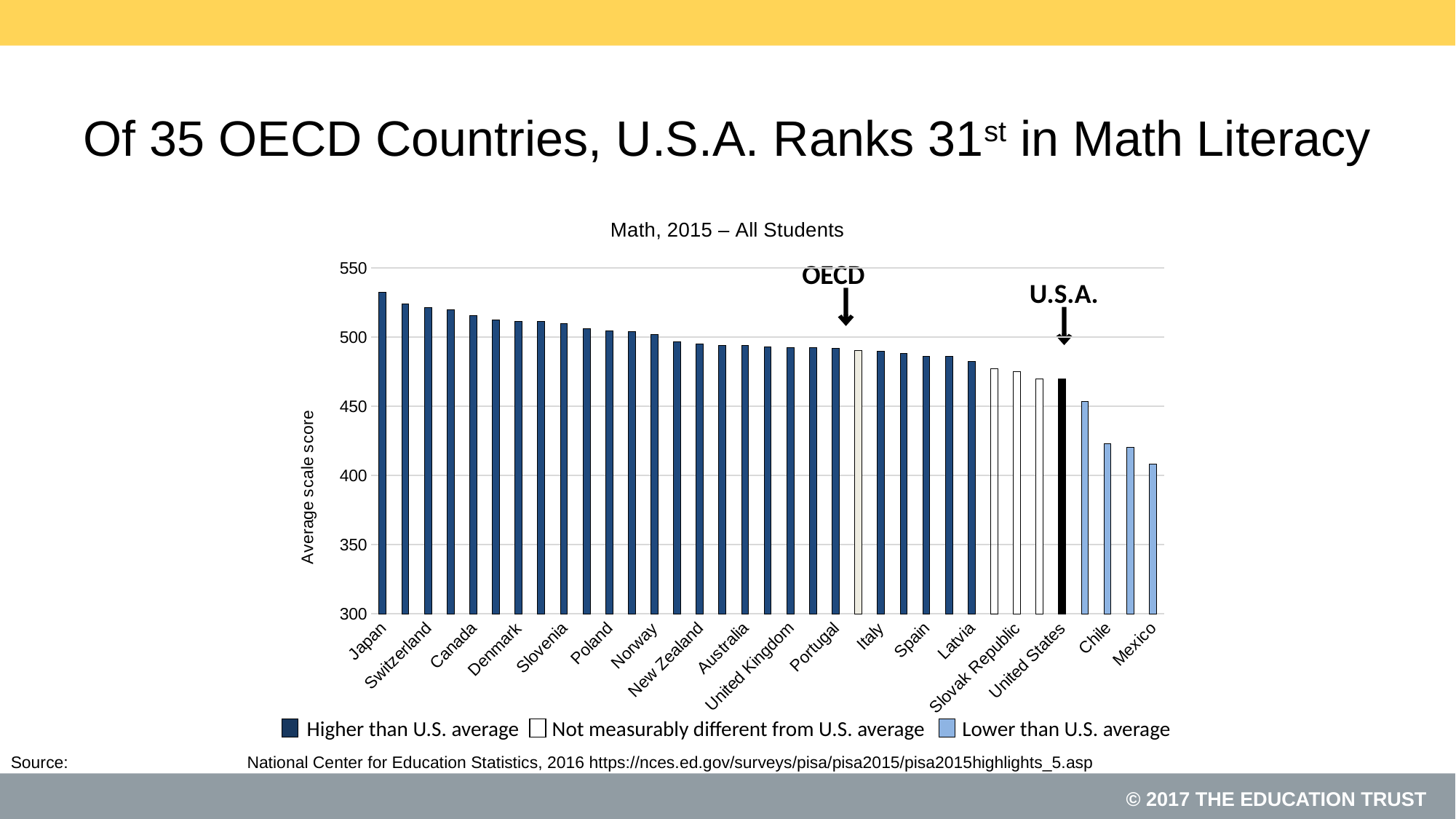
Which country has the lowest average scale score? Mexico Is the value for Japan greater or less than 500? greater Do the values rise or fall moving from left to right along the x axis? fall Is the value for United States greater or less than 500? less What is the title of the chart? Math, 2015 – All Students How many entries does the legend list? 3 Which has a higher average scale score, Canada or Chile? Canada What kind of chart is shown on the slide? bar chart Is the value for Canada greater or less than 500? greater Which country has the highest average scale score? Japan